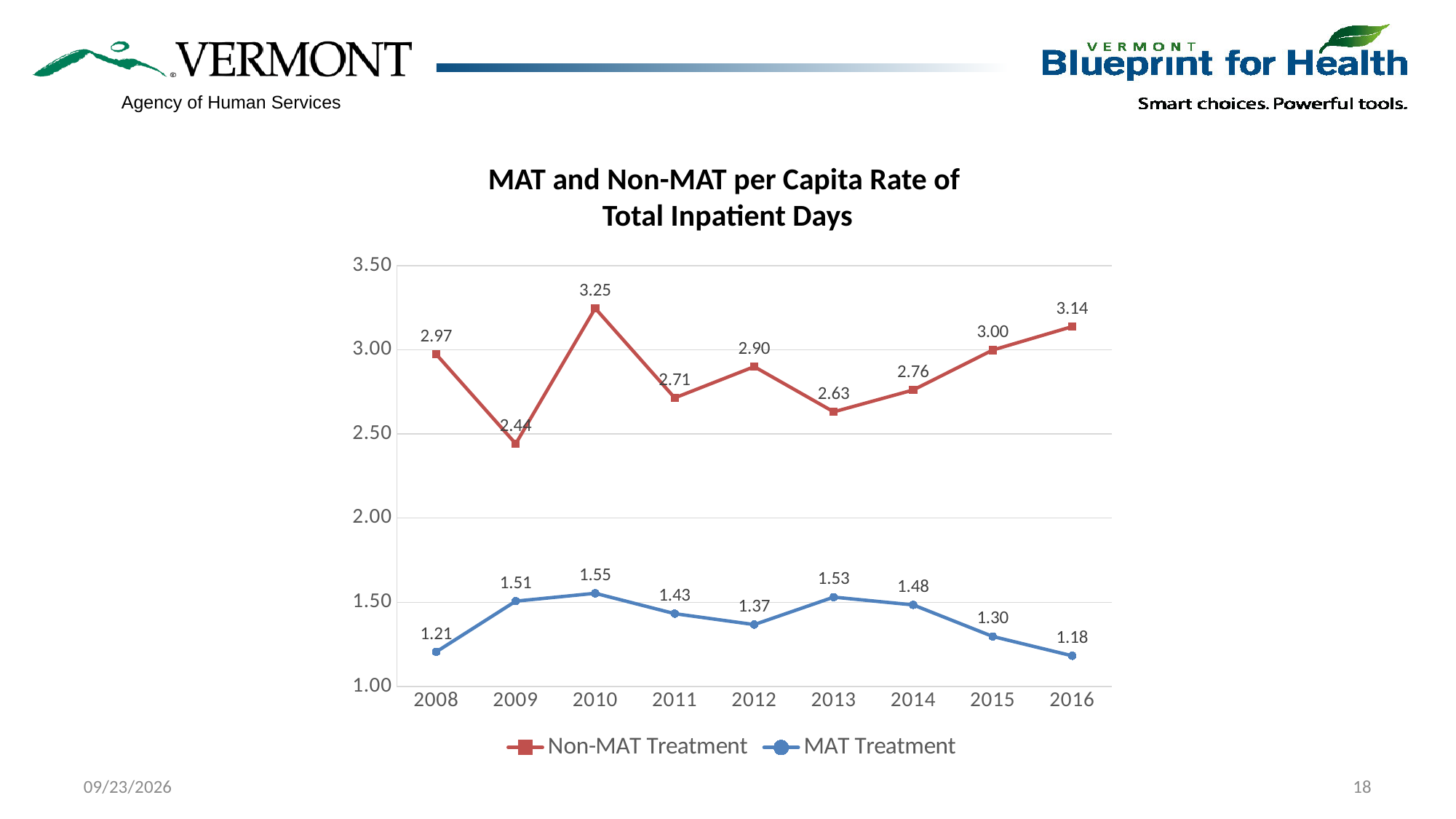
Does the MAT Treatment value rise or fall from 2014 to 2016? fall What is the Non-MAT Treatment value for 2010? 3.25 What is the MAT Treatment value for 2016? 1.18 Is the Non-MAT Treatment value for 2009 greater or less than 2.50? less What is the difference between the Non-MAT Treatment and MAT Treatment values in 2008? 1.76 In which year is the MAT Treatment value lowest? 2016 How many years are shown on the x axis? 9 In which year is the Non-MAT Treatment value highest? 2010 What colour is the line for Non-MAT Treatment? red What kind of chart is shown? line chart How many series does the legend list? 2 Which is larger, the MAT Treatment value in 2010 or in 2015? 2010